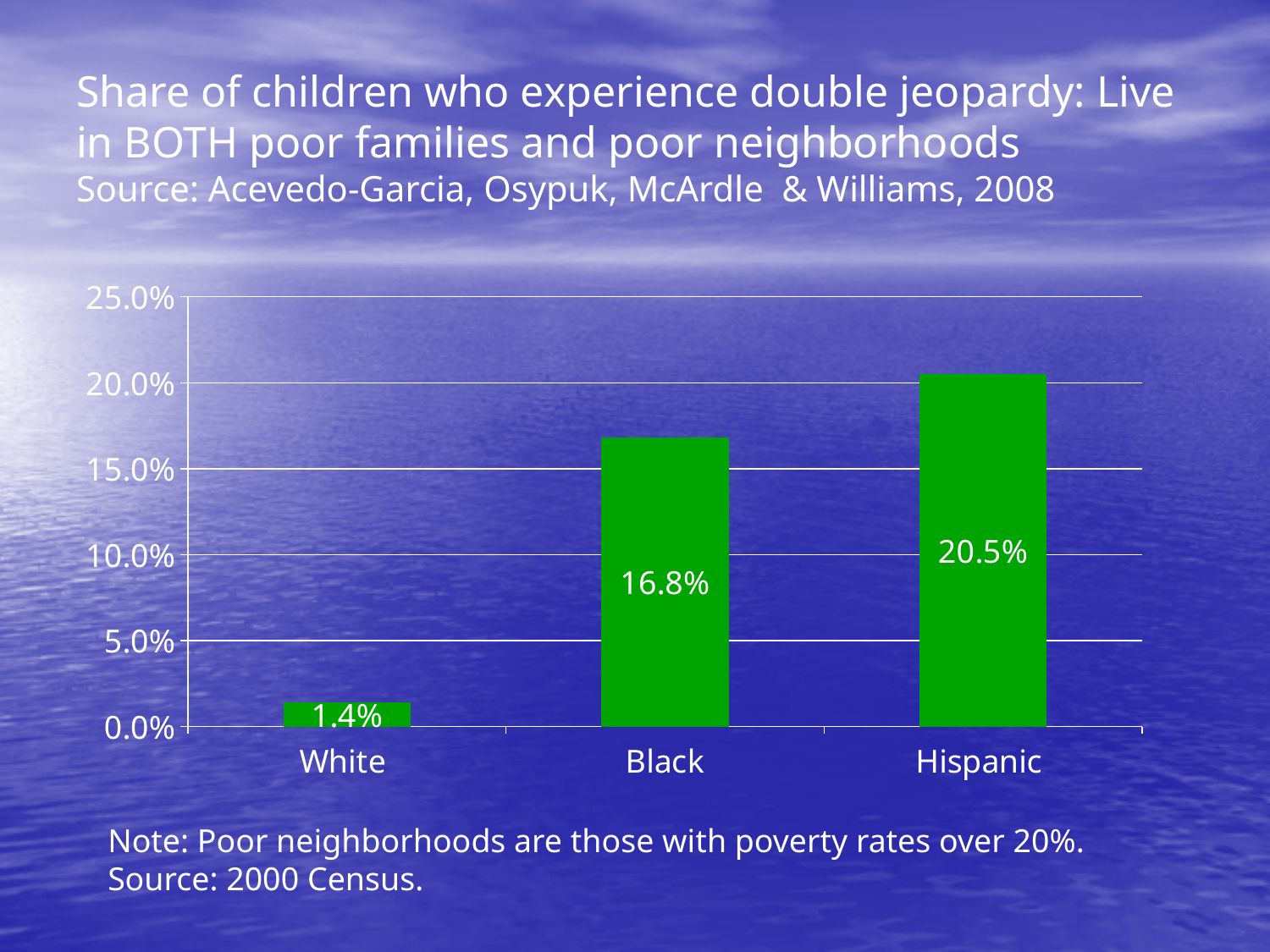
What is the difference between the values for Hispanic and Black? 3.7% What is the value for Black? 16.8% Which is larger, the value for Black or the value for Hispanic? Hispanic What is the value for White? 1.4% What is the difference between the values for Black and White? 15.4% How many categories are shown on the x axis? 3 What is the value for Hispanic? 20.5% What kind of chart is shown on the slide? bar chart Which category has the lowest value? White Which category has the highest value? Hispanic Is the value for Hispanic greater or less than 20.0%? greater Do the values rise or fall from left to right along the x axis? rise